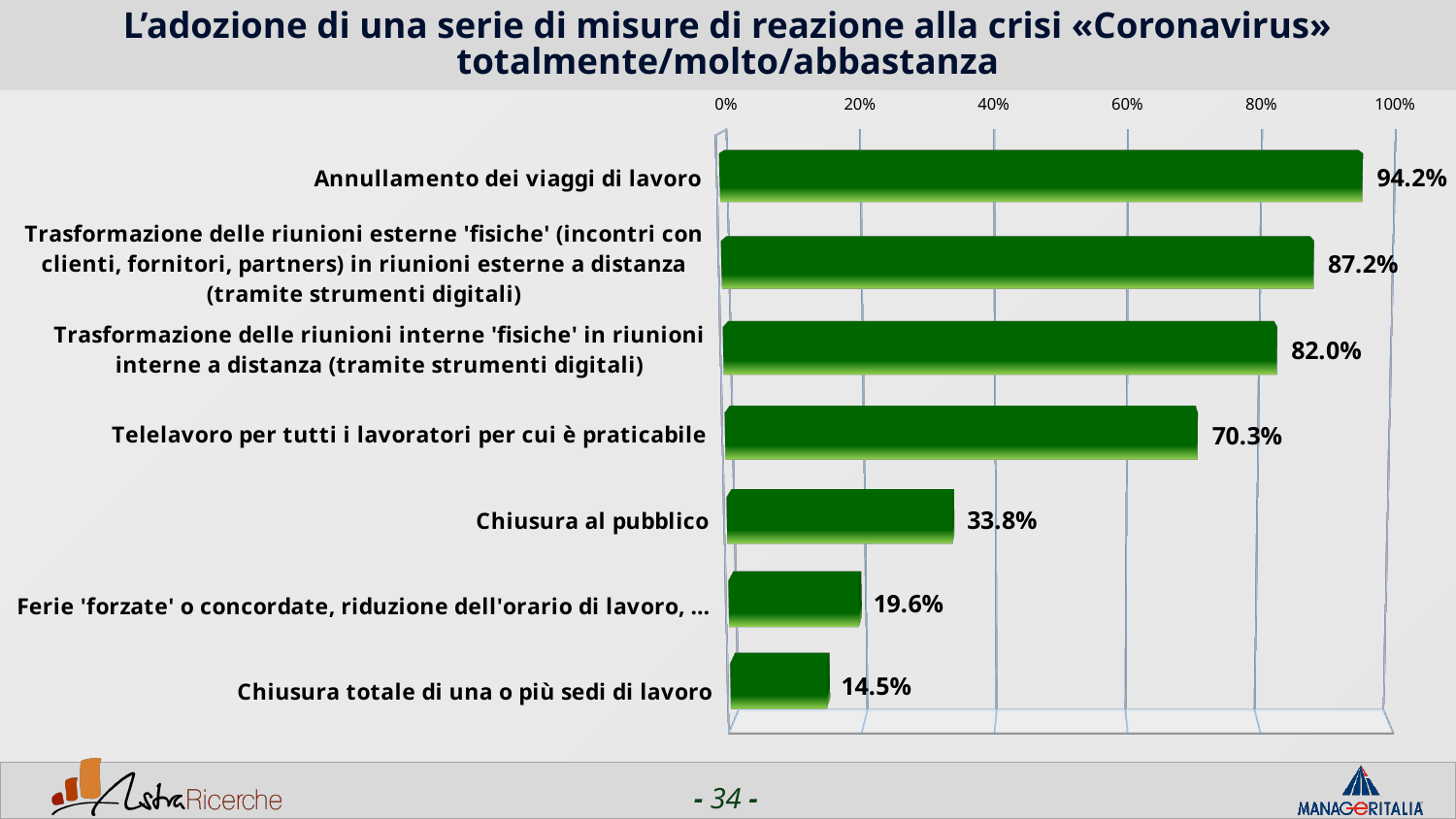
What is the value for 'Chiusura totale di una o più sedi di lavoro'? 14.5% Which category has the highest value? Annullamento dei viaggi di lavoro Which is larger: the value for 'Chiusura al pubblico' or the value for 'Ferie 'forzate' o concordate, riduzione dell'orario di lavoro, …'? Chiusura al pubblico What is the difference between the values for 'Annullamento dei viaggi di lavoro' and 'Telelavoro per tutti i lavoratori per cui è praticabile'? 23.9% Which category has the lowest value? Chiusura totale di una o più sedi di lavoro What kind of chart is shown on the slide? Bar chart What is the value for 'Telelavoro per tutti i lavoratori per cui è praticabile'? 70.3% What is the difference between the values for 'Chiusura al pubblico' and 'Chiusura totale di una o più sedi di lavoro'? 19.3% What is the value for 'Annullamento dei viaggi di lavoro'? 94.2% What is the value for 'Chiusura al pubblico'? 33.8% Is the value for 'Trasformazione delle riunioni interne 'fisiche' in riunioni interne a distanza (tramite strumenti digitali)' greater or less than 80%? greater How many categories are shown in the chart? 7